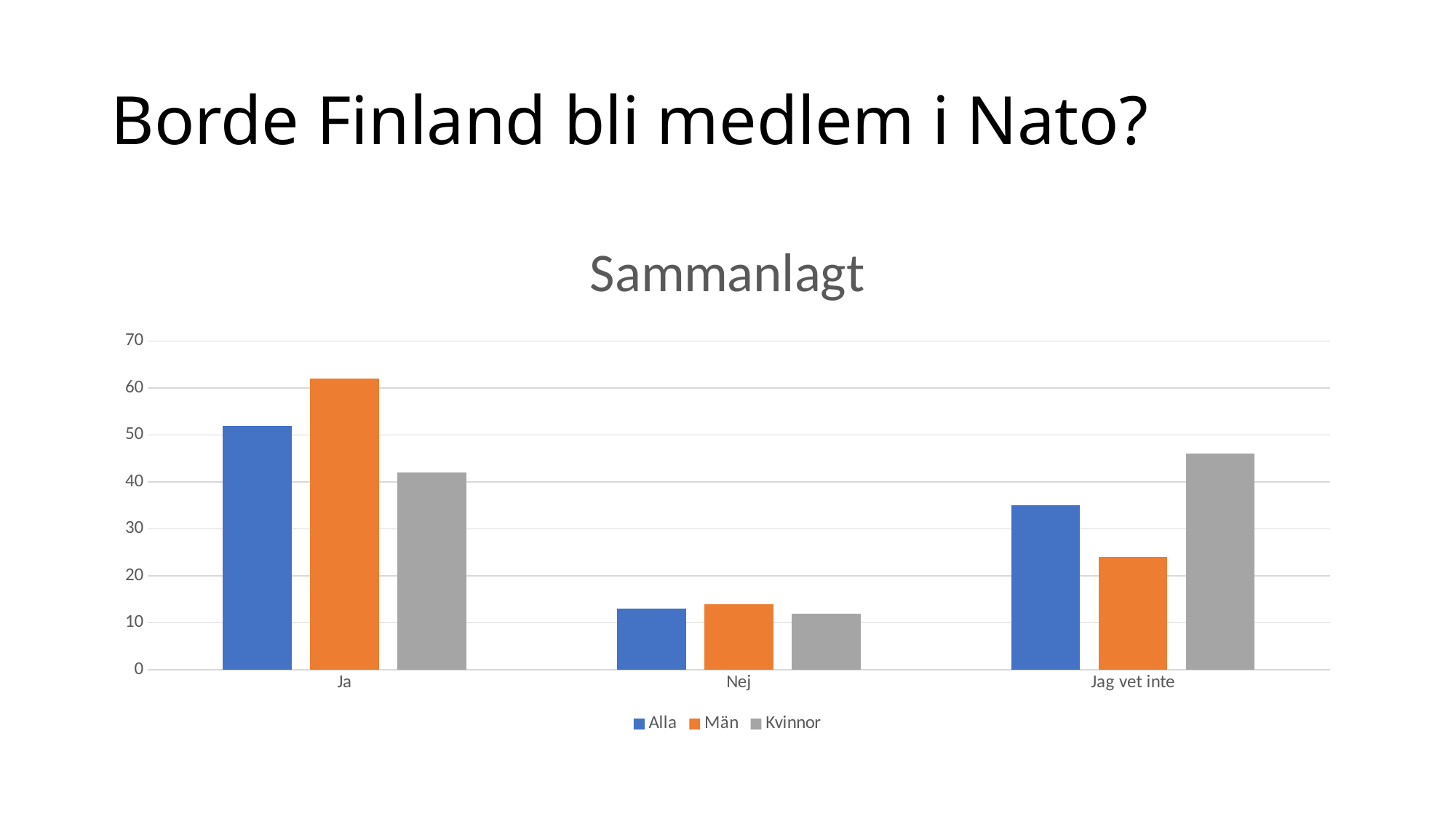
Is the value for Alla in the Nej category greater or less than 20? less What kind of chart is shown on the slide? bar chart How many categories are shown on the x axis? 3 Which is larger for the Alla series: the Ja bar or the Jag vet inte bar? Ja How many series does the legend list? 3 What is the title of the chart? Sammanlagt Is the value for Kvinnor in the Ja category greater or less than 50? less Which series has the highest bar in the Jag vet inte category? Kvinnor Is the value for Kvinnor in the Jag vet inte category greater or less than 40? greater For the Alla series, which category has the lowest bar? Nej Which series has the highest bar in the Ja category? Män